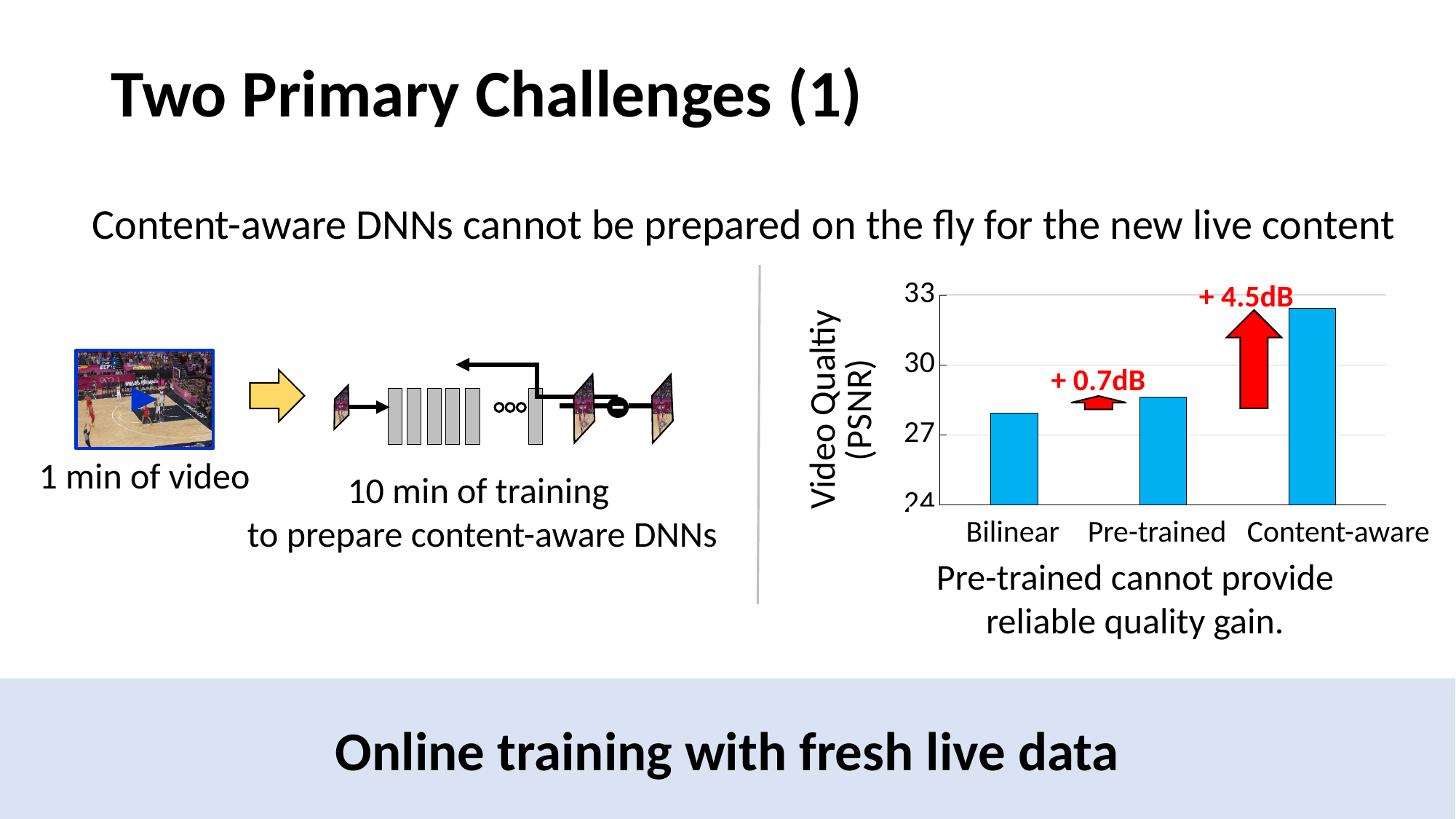
Do the bar values rise or fall from Bilinear to Content-aware along the x axis? rise What gain is annotated above the Pre-trained bar? + 0.7dB What gain is annotated above the Content-aware bar? + 4.5dB What kind of chart is shown on the right side of the slide? bar chart Which category has the lowest video quality (PSNR) in the bar chart? Bilinear How many categories are shown on the x axis of the bar chart? 3 Which category has the highest video quality (PSNR) in the bar chart? Content-aware Is the value for Bilinear greater or less than 27? greater Is the value for Pre-trained greater or less than 30? less What is the label of the y axis of the bar chart? Video Qualtiy (PSNR) Is the value for Content-aware greater or less than 30? greater Which has a higher PSNR value, Pre-trained or Bilinear? Pre-trained